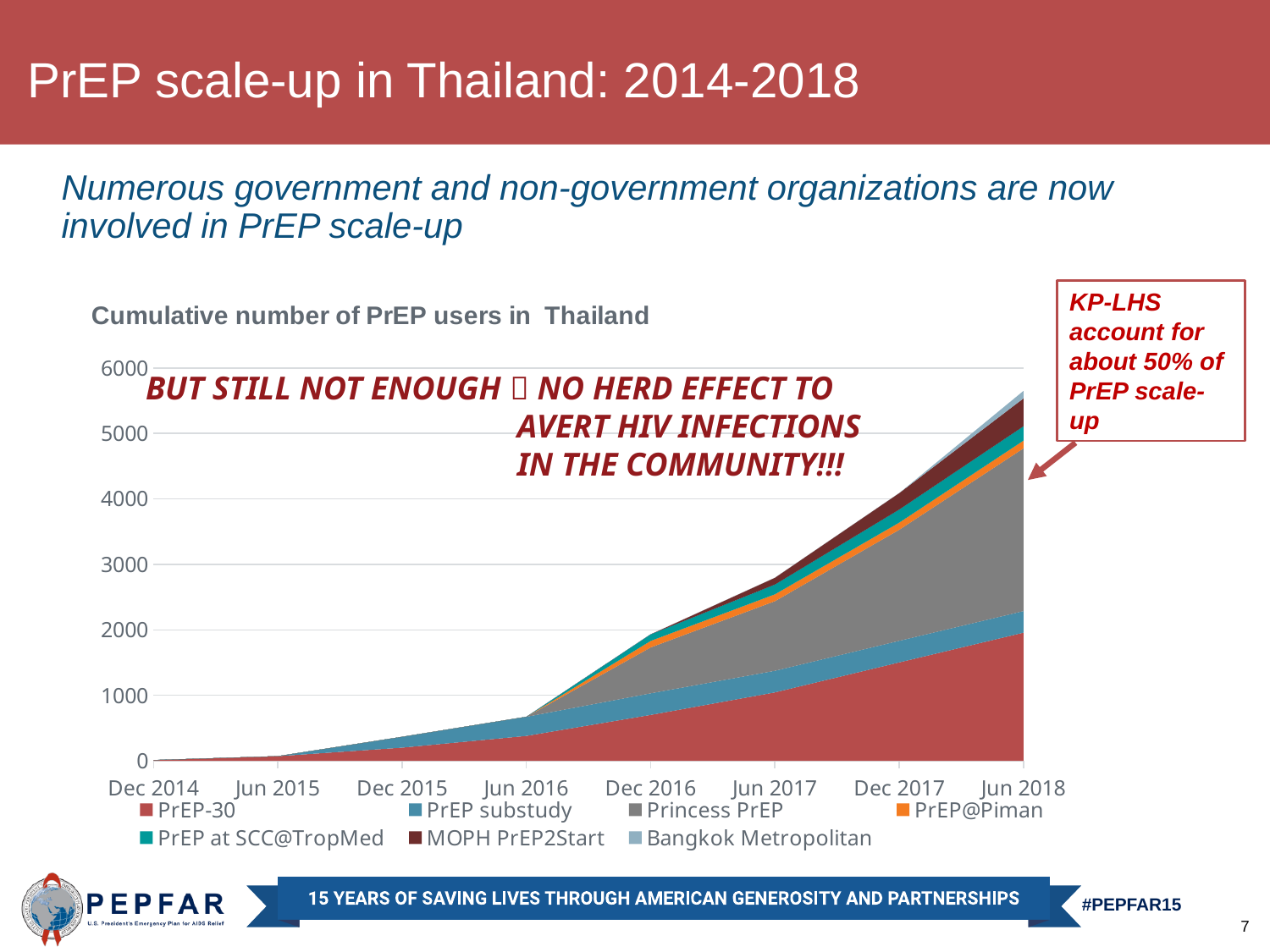
Does the cumulative number of PrEP users rise or fall from Dec 2014 to Jun 2018? Rise Is the total cumulative number of PrEP users at Jun 2017 greater or less than 2000? greater What is the first date label on the x axis of the chart? Dec 2014 What is the title of the chart? Cumulative number of PrEP users in Thailand Is the total cumulative number of PrEP users at Dec 2017 greater or less than 3000? greater Which series is shown in red at the bottom of the stacked area chart? PrEP-30 How many series does the chart's legend list? 7 What kind of chart is shown on the slide? Stacked area chart Is the total cumulative number of PrEP users at Jun 2018 greater or less than 5000? greater How many date labels are shown along the x axis of the chart? 8